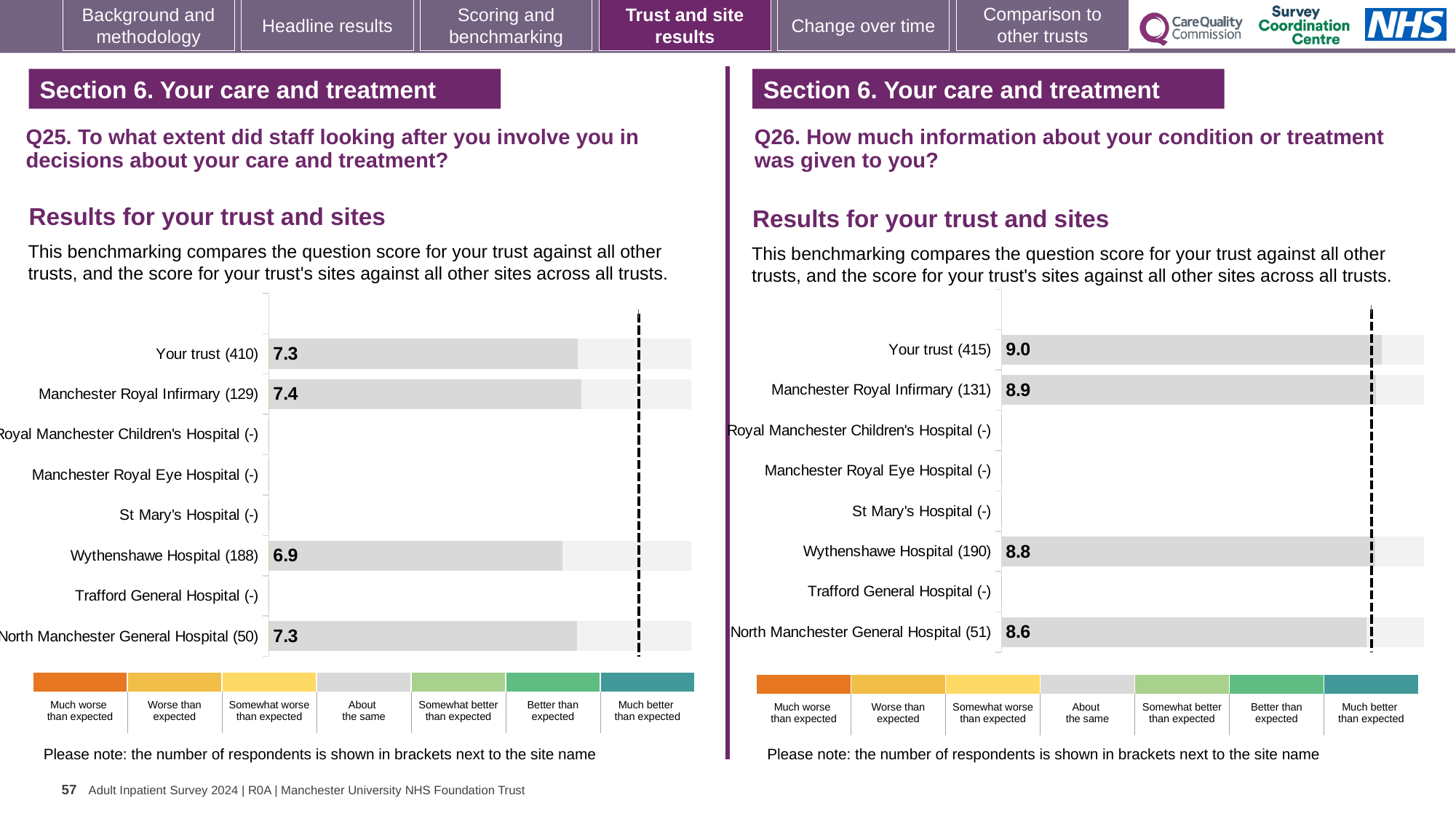
In the Q25 chart on the left, which site with a plotted score has the lowest value? Wythenshawe Hospital In the Q25 chart on the left, what is the score for Manchester Royal Infirmary? 7.4 In the Q26 chart on the right, which is larger: the score for Manchester Royal Infirmary or Wythenshawe Hospital? Manchester Royal Infirmary In the Q26 chart on the right, what is the score for North Manchester General Hospital? 8.6 In the Q25 chart on the left, what is the score for Your trust? 7.3 In the Q26 chart on the right, which row has the highest score? Your trust In the Q26 chart on the right, what is the difference between the scores for Your trust and North Manchester General Hospital? 0.4 In the Q25 chart on the left, what is the difference between the scores for Manchester Royal Infirmary and Wythenshawe Hospital? 0.5 How many rows (trust and sites) are listed on the Q25 chart on the left? 8 What kind of chart is used for the Q26 results on the right? Bar chart In the Q25 chart on the left, what is the score for Wythenshawe Hospital? 6.9 In the Q26 chart on the right, what is the score for Your trust? 9.0